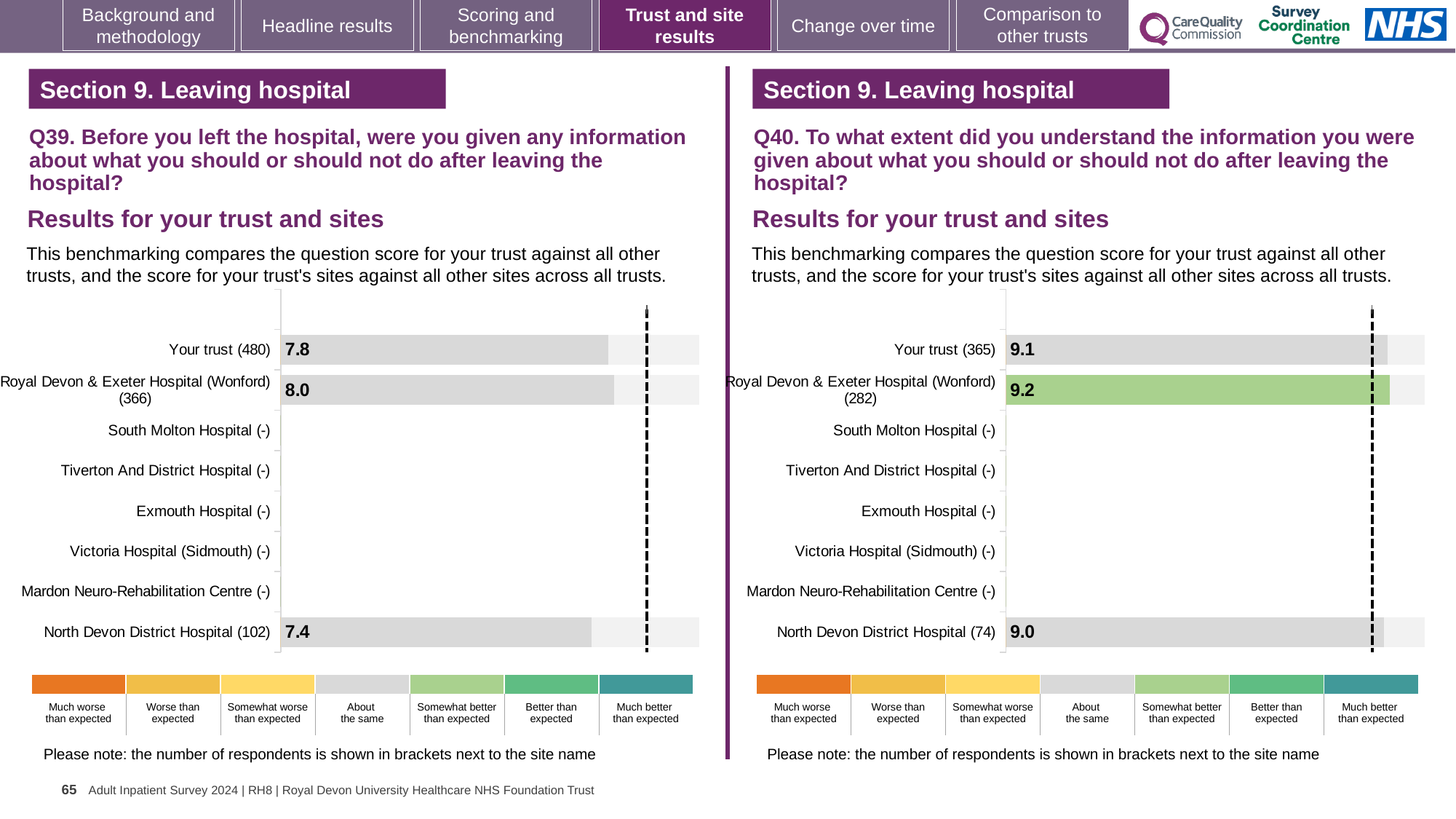
On the Q40 chart (right), which row has the lowest printed score? North Devon District Hospital (74) On the Q39 chart (left), which site or trust row has the highest score? Royal Devon & Exeter Hospital (Wonford) (366) On the Q40 chart (right), which row's bar is coloured green rather than grey? Royal Devon & Exeter Hospital (Wonford) (282) On the Q40 chart (right), what is the score for Your trust (365)? 9.1 What type of chart is used on the Q40 chart (right)? Bar chart On the Q40 chart (right), what is the score for Royal Devon & Exeter Hospital (Wonford) (282)? 9.2 On the Q39 chart (left), what is the score for Your trust (480)? 7.8 On the Q39 chart (left), what is the difference between the scores for Royal Devon & Exeter Hospital (Wonford) and North Devon District Hospital? 0.6 On the Q40 chart (right), which is larger: the score for Your trust or the score for North Devon District Hospital? Your trust How many site or trust rows are listed on the Q39 chart (left)? 8 On the Q39 chart (left), what is the score for North Devon District Hospital (102)? 7.4 On the Q40 chart (right), what is the difference between the scores for Royal Devon & Exeter Hospital (Wonford) and North Devon District Hospital? 0.2